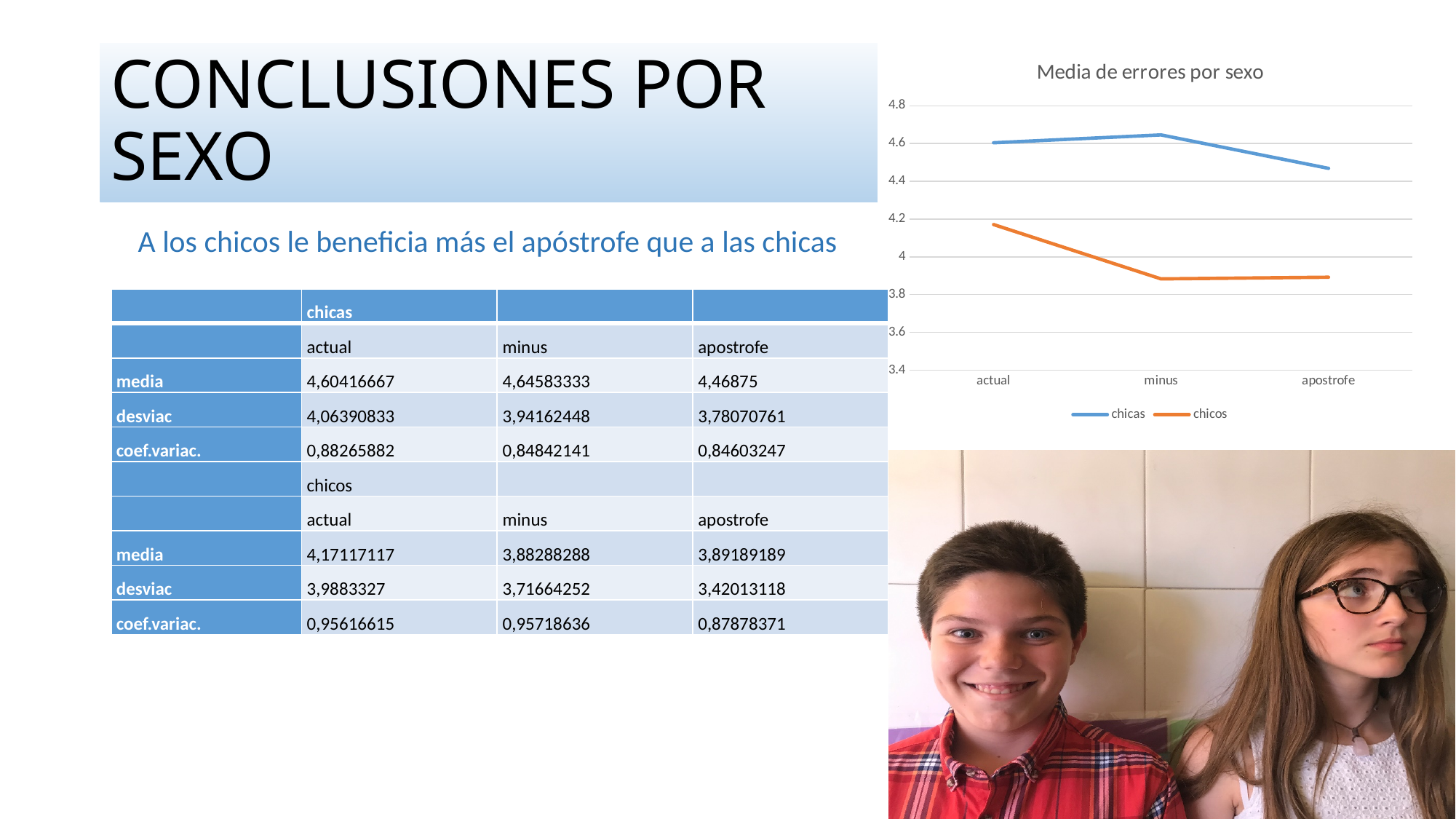
What colour is the chicos line in the 'Media de errores por sexo' chart? orange In the 'Media de errores por sexo' chart, which series has the higher value for 'actual', chicas or chicos? chicas What type of chart is 'Media de errores por sexo'? line chart In the 'Media de errores por sexo' chart, does the chicas line rise or fall from 'minus' to 'apostrofe'? fall How many series does the legend of the 'Media de errores por sexo' chart list? 2 In the 'Media de errores por sexo' chart, does the chicos line rise or fall from 'actual' to 'minus'? fall In the 'Media de errores por sexo' chart, is the chicos value for 'actual' greater or less than 4? greater In the 'Media de errores por sexo' chart, for which category is the chicos line highest? actual How many categories are shown on the x axis of the 'Media de errores por sexo' chart? 3 In the 'Media de errores por sexo' chart, is the chicos value for 'minus' greater or less than 4? less In the 'Media de errores por sexo' chart, for which category is the chicas line lowest? apostrofe In the 'Media de errores por sexo' chart, is the chicas value for 'actual' greater or less than 4.4? greater